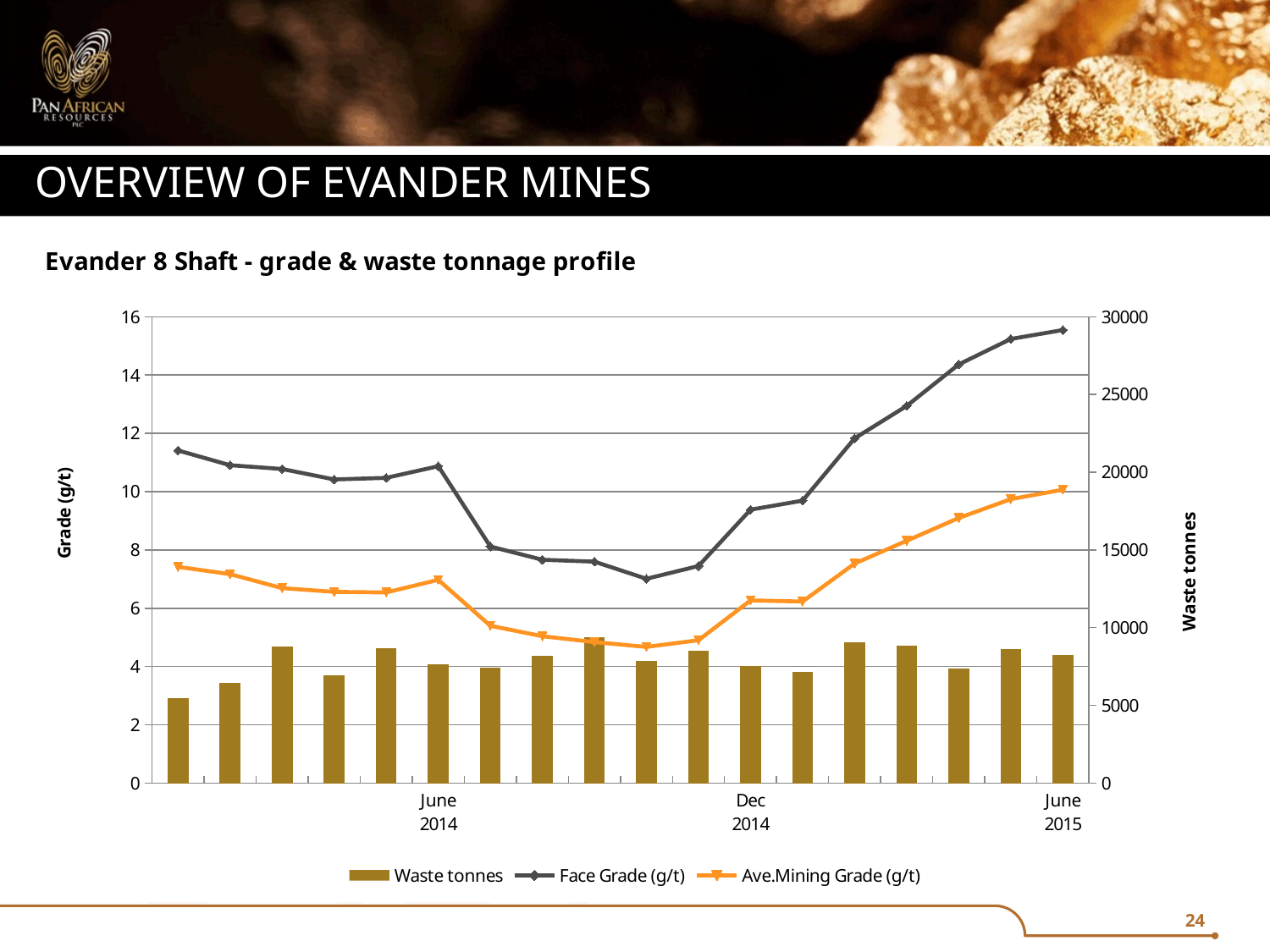
What kind of chart is this? Combined bar and line chart How many series does the legend list? 3 At June 2015, which is larger: Face Grade (g/t) or Ave.Mining Grade (g/t)? Face Grade (g/t) Is the Face Grade (g/t) value at June 2015 greater or less than 14? greater At which labelled month does the Face Grade (g/t) line reach its highest value? June 2015 Does the Face Grade (g/t) line rise or fall between Dec 2014 and June 2015? rise Is the Ave.Mining Grade (g/t) value at June 2015 greater or less than 8? greater What is the label of the right-hand vertical axis? Waste tonnes Is the Ave.Mining Grade (g/t) value at Dec 2014 greater or less than 8? less What is the title of the chart? Evander 8 Shaft - grade & waste tonnage profile